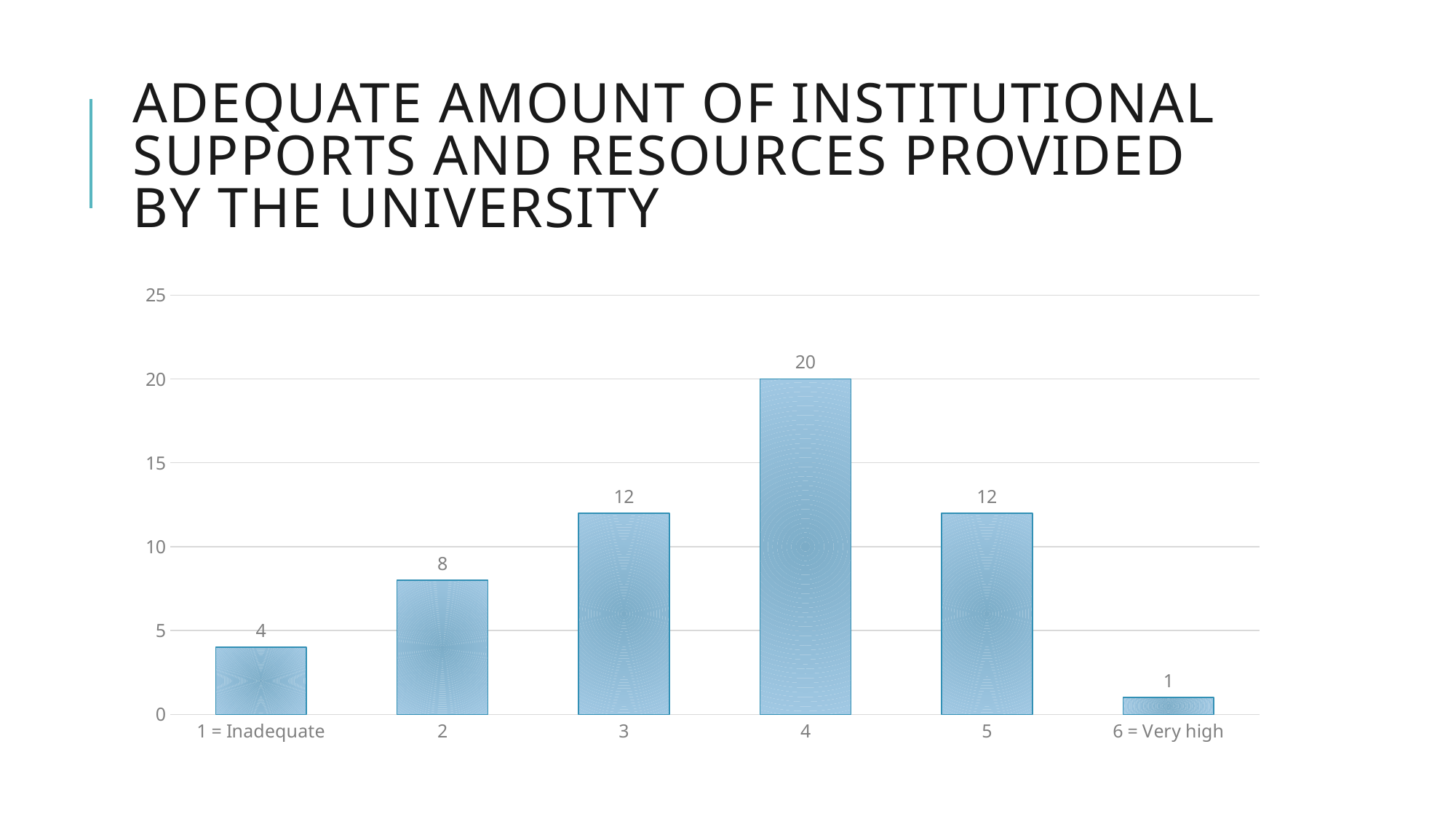
What is the value for the category "1 = Inadequate"? 4 Which is larger, the value for category "2" or the value for category "5"? 5 How many categories are shown on the x axis? 6 What is the value for the category "4"? 20 What is the value for the category "2"? 8 Is the value for category "4" greater or less than 15? greater Which category has the highest value? 4 What is the difference between the values for category "4" and category "3"? 8 What is the value for the category "6 = Very high"? 1 What is the title of the slide? Adequate amount of institutional supports and resources provided by the university Which category has the lowest value? 6 = Very high What kind of chart is shown on the slide? bar chart